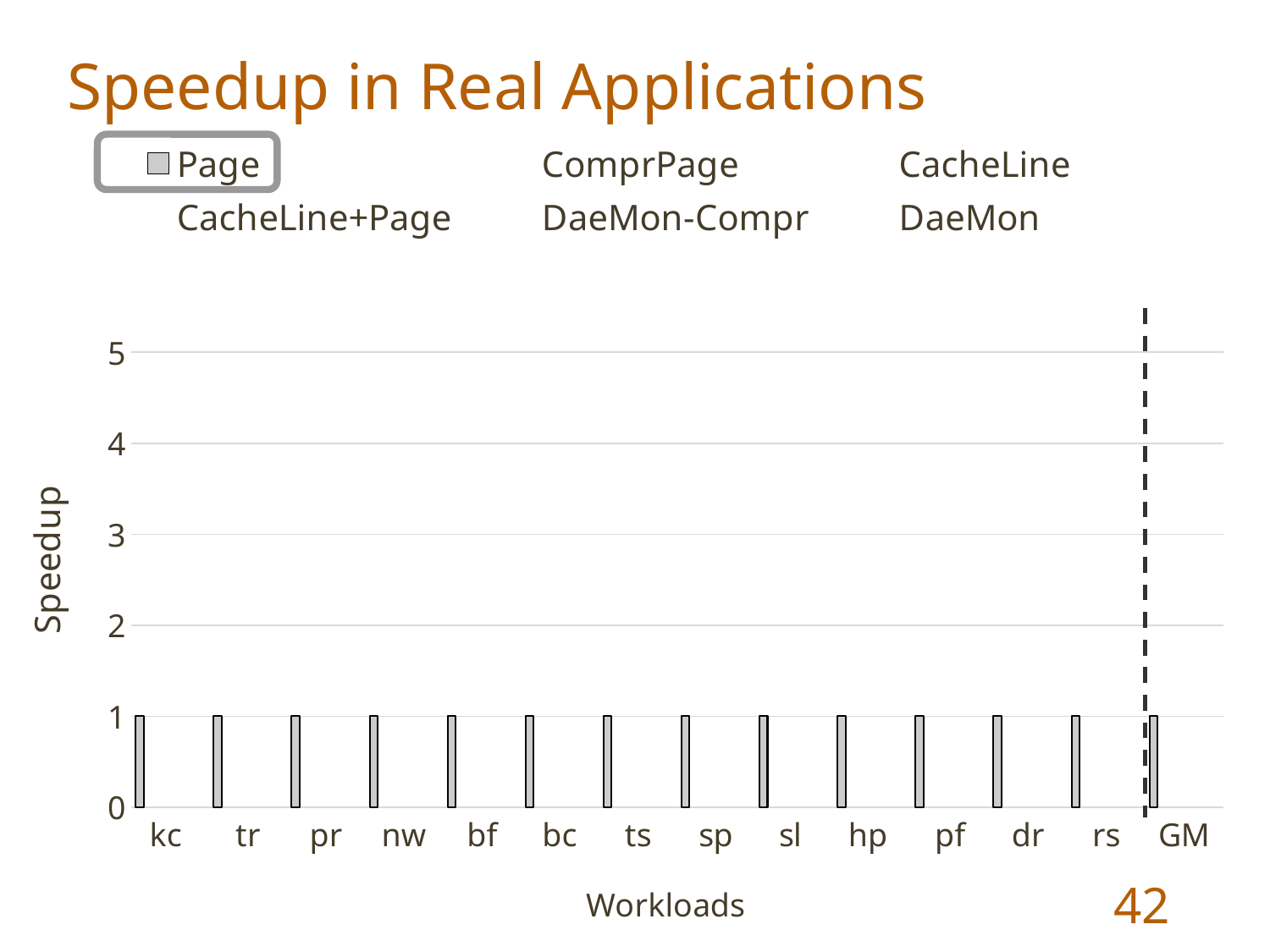
What is the Page speedup for the GM workload? 1 What is the label of the y axis? Speedup What is the difference between the Page speedup for tr and the Page speedup for pf? 0 Is the Page value for the bf workload greater or less than 2? less Is the Page value for the rs workload greater or less than 3? less How many workloads are shown along the x axis? 14 Do the Page values rise, fall, or stay flat across the workloads from kc to GM? stay flat What kind of chart is shown on the slide? bar chart What is the Page speedup for the sp workload? 1 What is the Page speedup for the kc workload? 1 How many series does the legend list? 6 What is the title of the slide's chart? Speedup in Real Applications